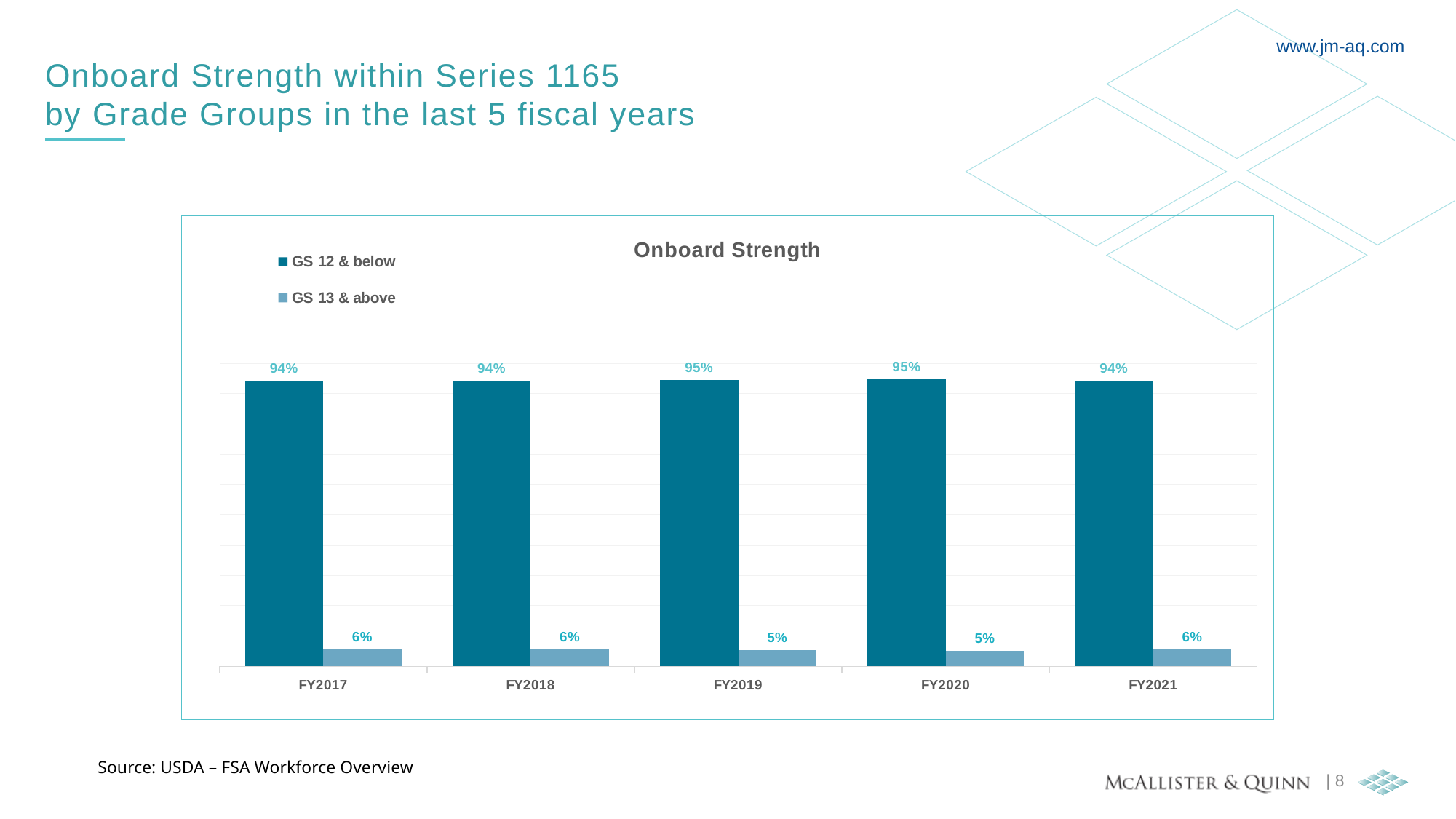
What is the difference between the GS 13 & above values in FY2017 and FY2019? 1% What is the value for GS 12 & below in FY2019? 95% What is the value for GS 12 & below in FY2021? 94% What is the value for GS 13 & above in FY2020? 5% What kind of chart is shown? Bar chart What is the value for GS 13 & above in FY2017? 6% How many fiscal years are shown on the x axis? 5 What is the difference between the GS 12 & below and GS 13 & above values in FY2018? 88% How many series does the legend list? 2 What is the title of the chart? Onboard Strength Which is larger in FY2020, GS 12 & below or GS 13 & above? GS 12 & below Which series is shown in the darker teal colour? GS 12 & below